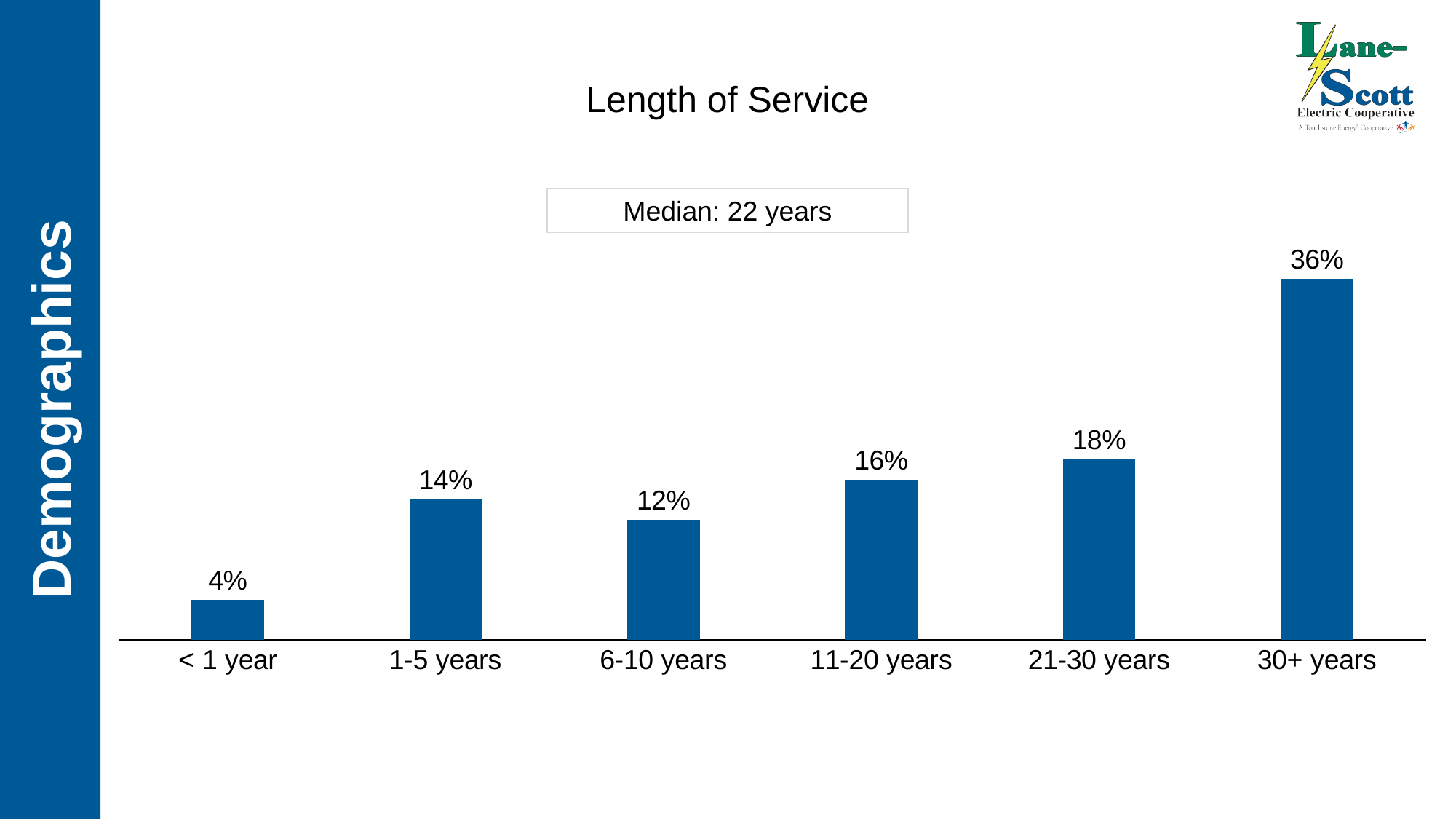
What is the value for the < 1 year category? 4% What kind of chart is shown on the slide? Bar chart What is the value for the 6-10 years category? 12% What is the value for the 30+ years category? 36% What is the value for the 21-30 years category? 18% What is the difference between the values for 30+ years and 21-30 years? 18% Which category has the highest value? 30+ years Which category has the lowest value? < 1 year What is the difference between the values for 1-5 years and 6-10 years? 2% Which is larger, the value for 11-20 years or the value for 6-10 years? 11-20 years What is the title of the chart? Length of Service How many categories are shown on the chart? 6